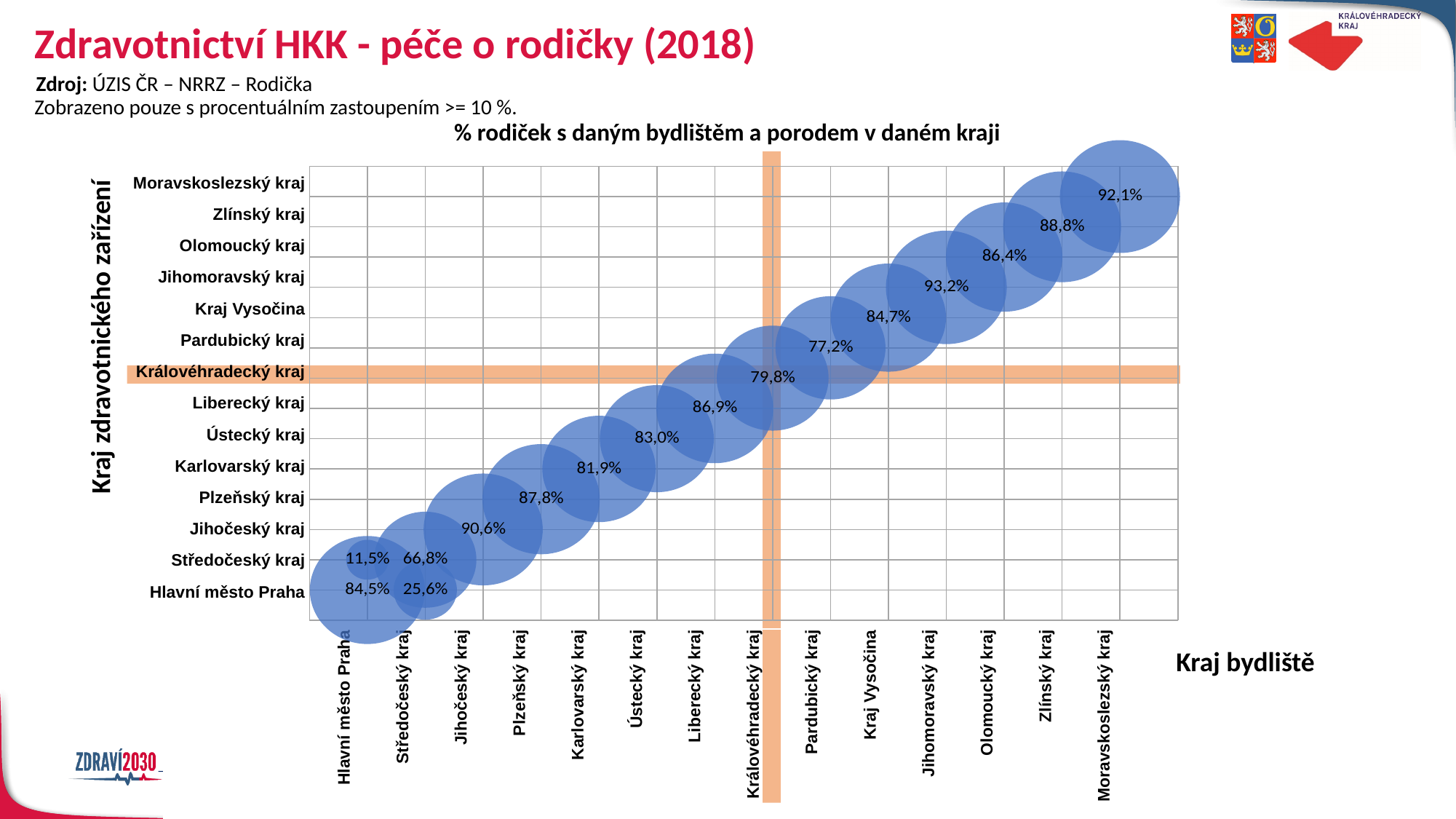
What percentage of mothers living in Jihomoravský kraj gave birth in Jihomoravský kraj? 93,2% What is the difference between the same-region birth percentage for Moravskoslezský kraj (92,1%) and Pardubický kraj (77,2%)? 14,9 percentage points Which region of residence has the highest percentage of mothers giving birth in the same region? Jihomoravský kraj What percentage of mothers living in Královéhradecký kraj gave birth in Královéhradecký kraj? 79,8% How many regions are listed on the x axis (Kraj bydliště)? 14 What percentage of mothers living in Středočeský kraj gave birth in Hlavní město Praha? 25,6% Which is larger: the same-region birth percentage for Zlínský kraj or for Olomoucký kraj? Zlínský kraj What kind of chart is shown on the slide? Bubble chart Which region of residence has the lowest percentage of mothers giving birth in the same region? Středočeský kraj Which region is highlighted with orange bands on both axes? Královéhradecký kraj What percentage of mothers living in Hlavní město Praha gave birth in Středočeský kraj? 11,5% What is the title of the chart? % rodiček s daným bydlištěm a porodem v daném kraji